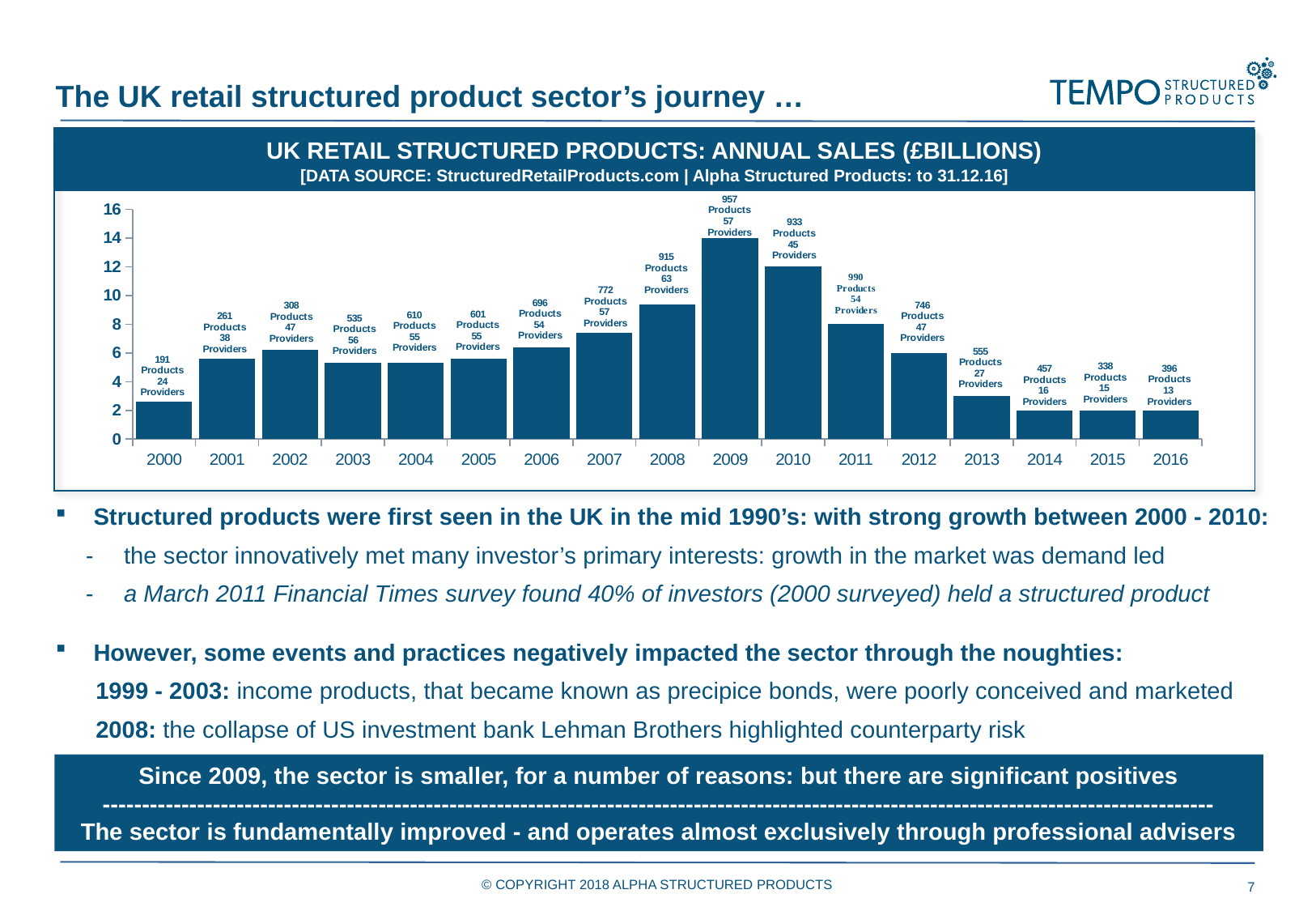
Is the annual sales value for 2009 greater or less than 12? greater Do annual sales rise or fall from 2009 to 2016? fall Which year has higher annual sales, 2010 or 2011? 2010 Which year has the highest annual sales in the chart? 2009 How many providers are labelled for 2016 in the chart? 13 Providers How many years are shown on the x axis of the chart? 17 How many products are labelled for 2009 in the chart? 957 Products What is the difference between the number of products labelled for 2009 and for 2016? 561 How many products are labelled for 2000 in the chart? 191 Products Is the annual sales value for 2000 greater or less than 4? less How many providers are labelled for 2009 in the chart? 57 Providers What kind of chart is shown on the slide? bar chart